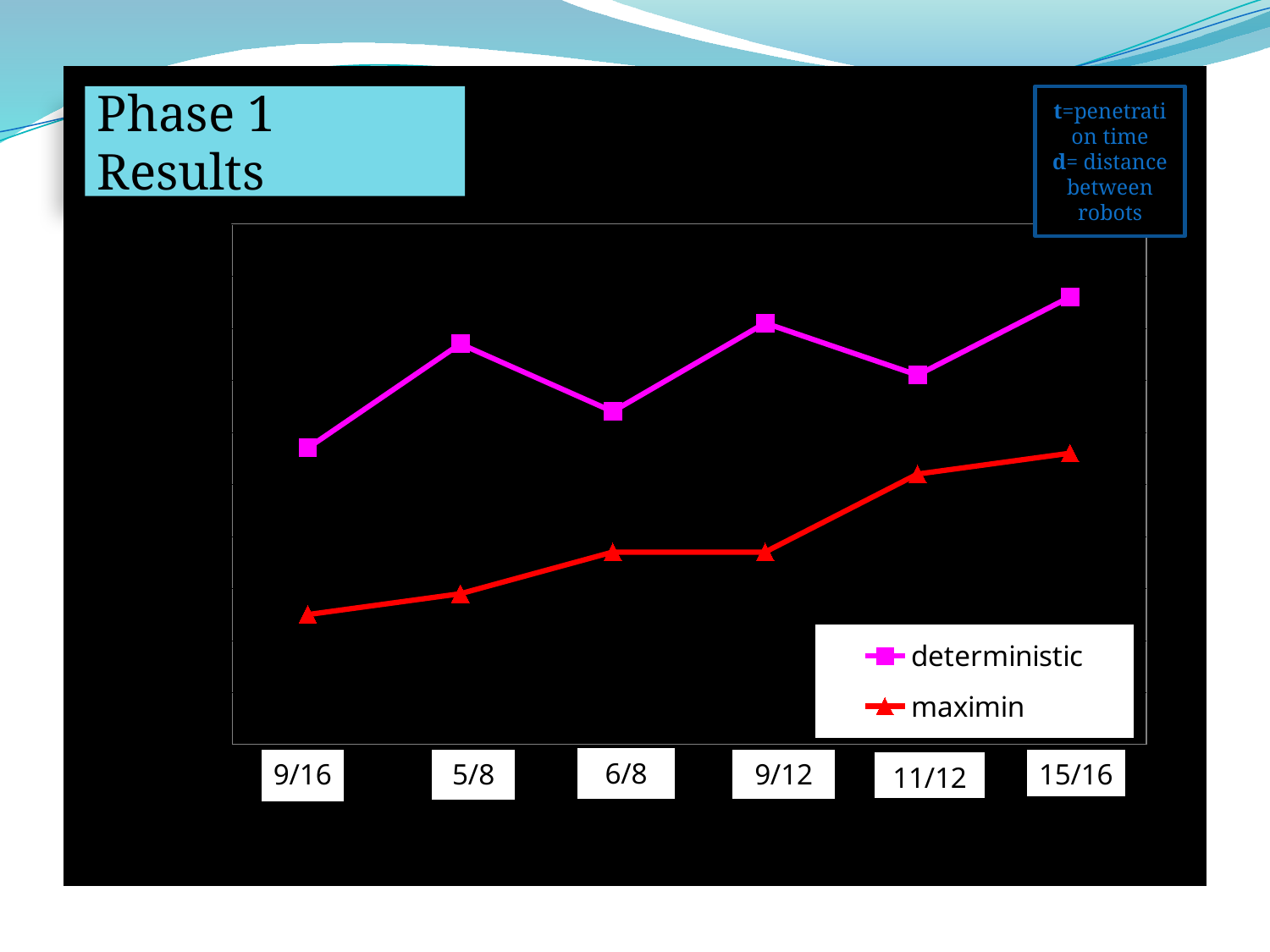
Does the maximin series generally rise or fall from 9/16 to 15/16? rise How many categories are shown along the x axis? 6 At which x-axis category does the maximin series have its lowest value? 9/16 At which x-axis category does the deterministic series have its lowest value? 9/16 What colour is the line for the maximin series? red At which x-axis category does the deterministic series reach its highest value? 15/16 Which series has the lower value at 9/16, deterministic or maximin? maximin How many series does the legend list? 2 Which series has the higher value at 9/12, deterministic or maximin? deterministic What kind of chart is shown on the slide? line chart Does the deterministic series rise or fall between 5/8 and 6/8? fall At which x-axis category does the maximin series reach its highest value? 15/16